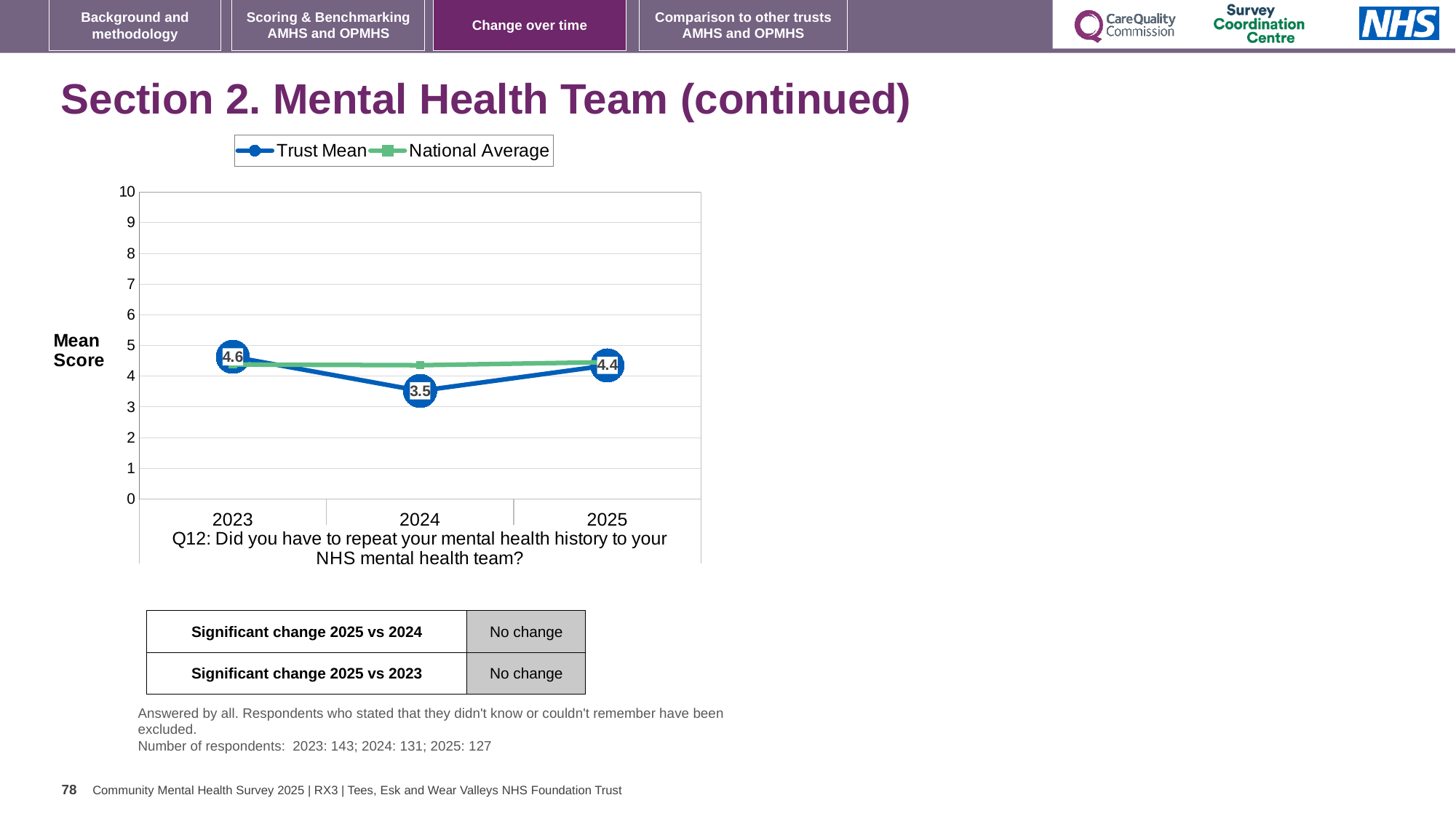
Is the National Average value for 2024 greater or less than 5? less What is the Trust Mean score for 2023? 4.6 What is the Trust Mean score for 2024? 3.5 What is the difference between the Trust Mean in 2023 and 2024? 1.1 In which year is the Trust Mean lowest? 2024 How many series does the legend list? 2 What kind of chart is shown? line chart Which is larger, the Trust Mean in 2024 or in 2025? 2025 Which series is shown in green in the legend? National Average What is the Trust Mean score for 2025? 4.4 How many years are shown on the x axis? 3 In which year is the Trust Mean highest? 2023